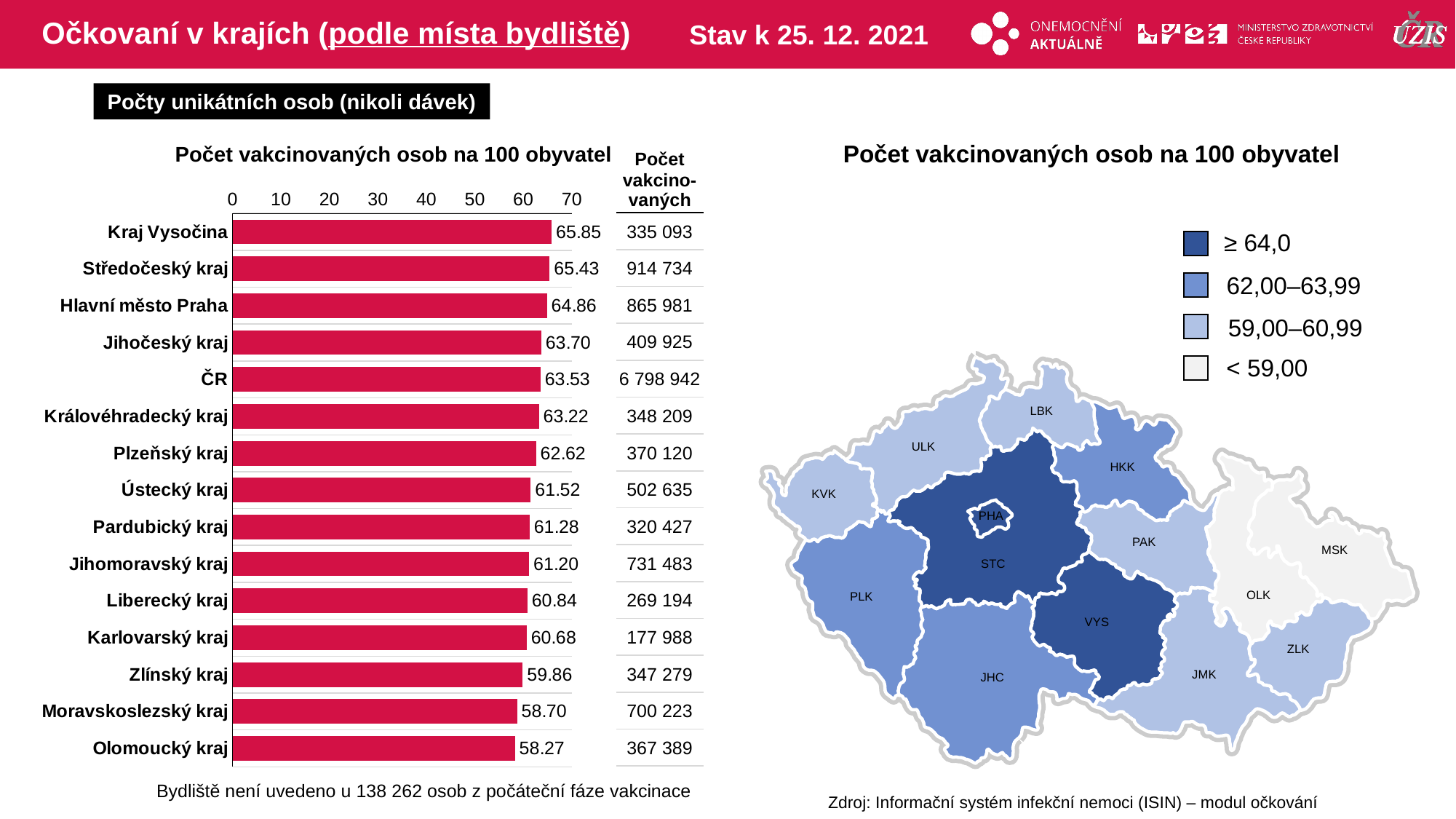
What kind of chart is shown on the left of the slide? bar chart In the bar chart, what is the value for ČR? 63.53 Do the bar values increase or decrease from the top of the chart to the bottom? decrease What is the title of the bar chart on the left? Počet vakcinovaných osob na 100 obyvatel What is the difference between the values for Kraj Vysočina and Olomoucký kraj in the bar chart? 7.58 How many bars (categories) are shown in the bar chart? 15 Which region has the lowest value in the bar chart? Olomoucký kraj In the bar chart, which has the larger value: Plzeňský kraj or Ústecký kraj? Plzeňský kraj What is the difference between the values for Středočeský kraj and Hlavní město Praha in the bar chart? 0.57 In the bar chart, is the value for Moravskoslezský kraj greater or less than 60? less In the bar chart, what is the value for Kraj Vysočina? 65.85 Which region has the highest value in the bar chart? Kraj Vysočina